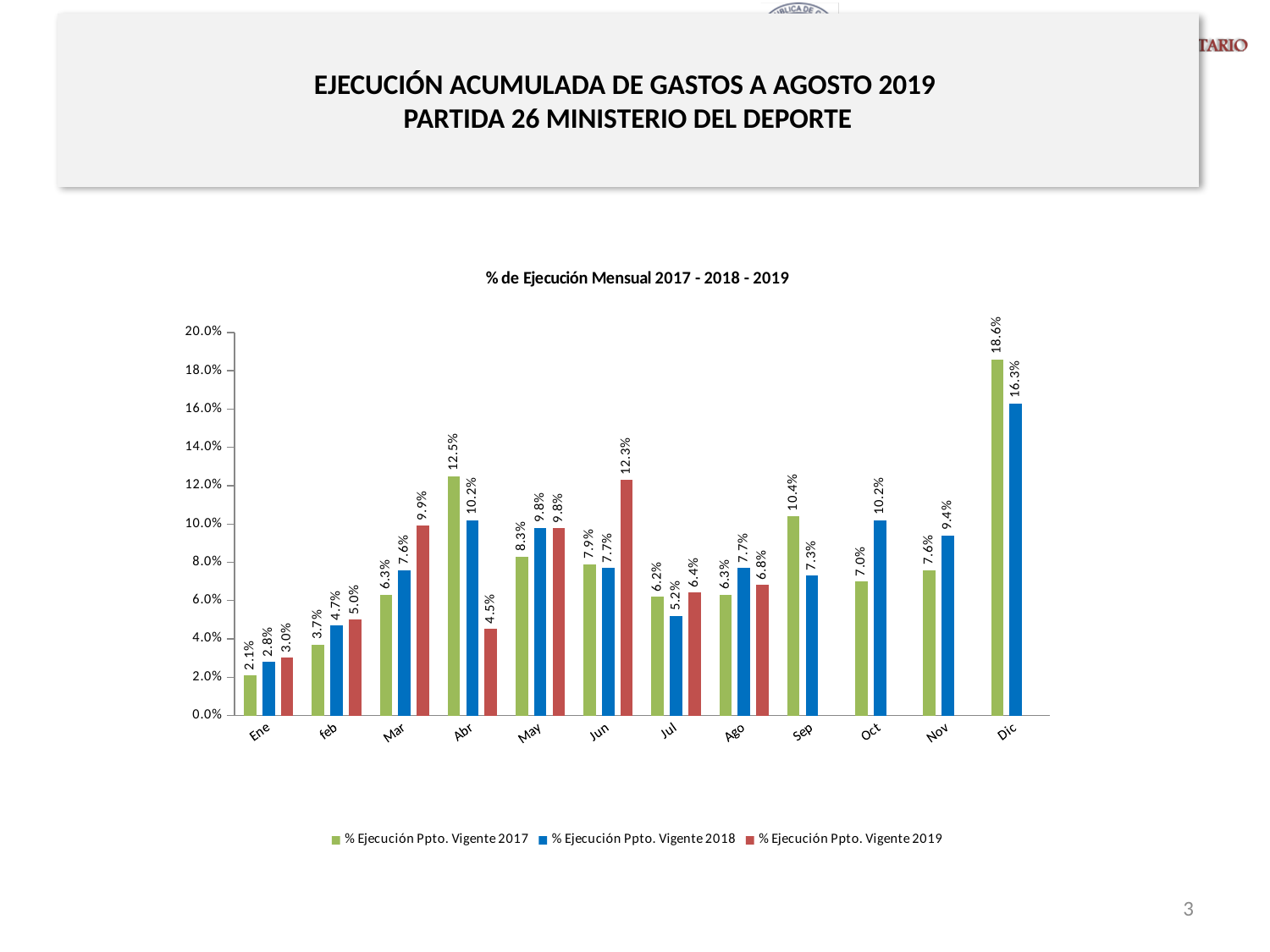
How many series does the legend list? 3 For Abr, which series has the larger value: % Ejecución Ppto. Vigente 2017 or % Ejecución Ppto. Vigente 2019? % Ejecución Ppto. Vigente 2017 What is the value for Oct in the % Ejecución Ppto. Vigente 2018 series? 10.2% What is the value for Jun in the % Ejecución Ppto. Vigente 2019 series? 12.3% How many months are shown on the x axis? 12 What is the title of the chart? % de Ejecución Mensual 2017 - 2018 - 2019 Which month has the highest value in the % Ejecución Ppto. Vigente 2017 series? Dic What is the difference between the 2017 and 2018 values for Dic? 2.3% What kind of chart is shown on the slide? Bar chart Which colour represents the % Ejecución Ppto. Vigente 2019 series? Red What is the value for Abr in the % Ejecución Ppto. Vigente 2017 series? 12.5% Which month has the lowest value in the % Ejecución Ppto. Vigente 2019 series? Ene